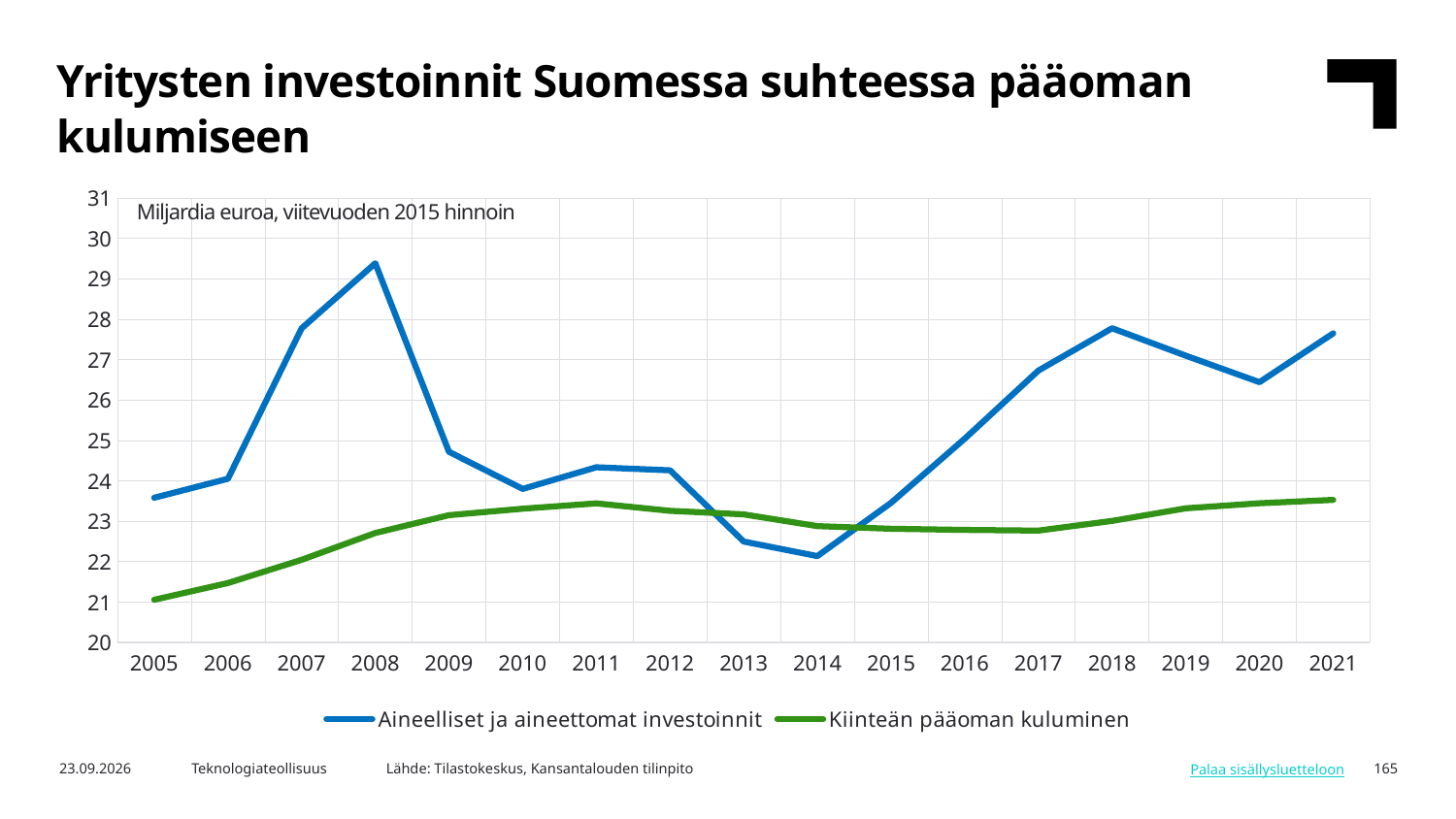
How many years are shown on the x axis? 17 Is the value for 'Aineelliset ja aineettomat investoinnit' in 2014 greater or less than 23? less What unit is stated in the text box inside the chart? Miljardia euroa, viitevuoden 2015 hinnoin In which year does the 'Aineelliset ja aineettomat investoinnit' series reach its highest value? 2008 Is the value for 'Kiinteän pääoman kuluminen' in 2005 greater or less than 22? less In which year is the 'Kiinteän pääoman kuluminen' series at its lowest? 2005 Does the 'Kiinteän pääoman kuluminen' series generally rise or fall from 2005 to 2021? rise In which year does the 'Aineelliset ja aineettomat investoinnit' series reach its lowest value? 2014 What kind of chart is shown on the slide? line chart Is the value for 'Aineelliset ja aineettomat investoinnit' in 2008 greater or less than 29? greater Which series has the larger value in 2013, 'Aineelliset ja aineettomat investoinnit' or 'Kiinteän pääoman kuluminen'? Kiinteän pääoman kuluminen How many series does the legend list? 2